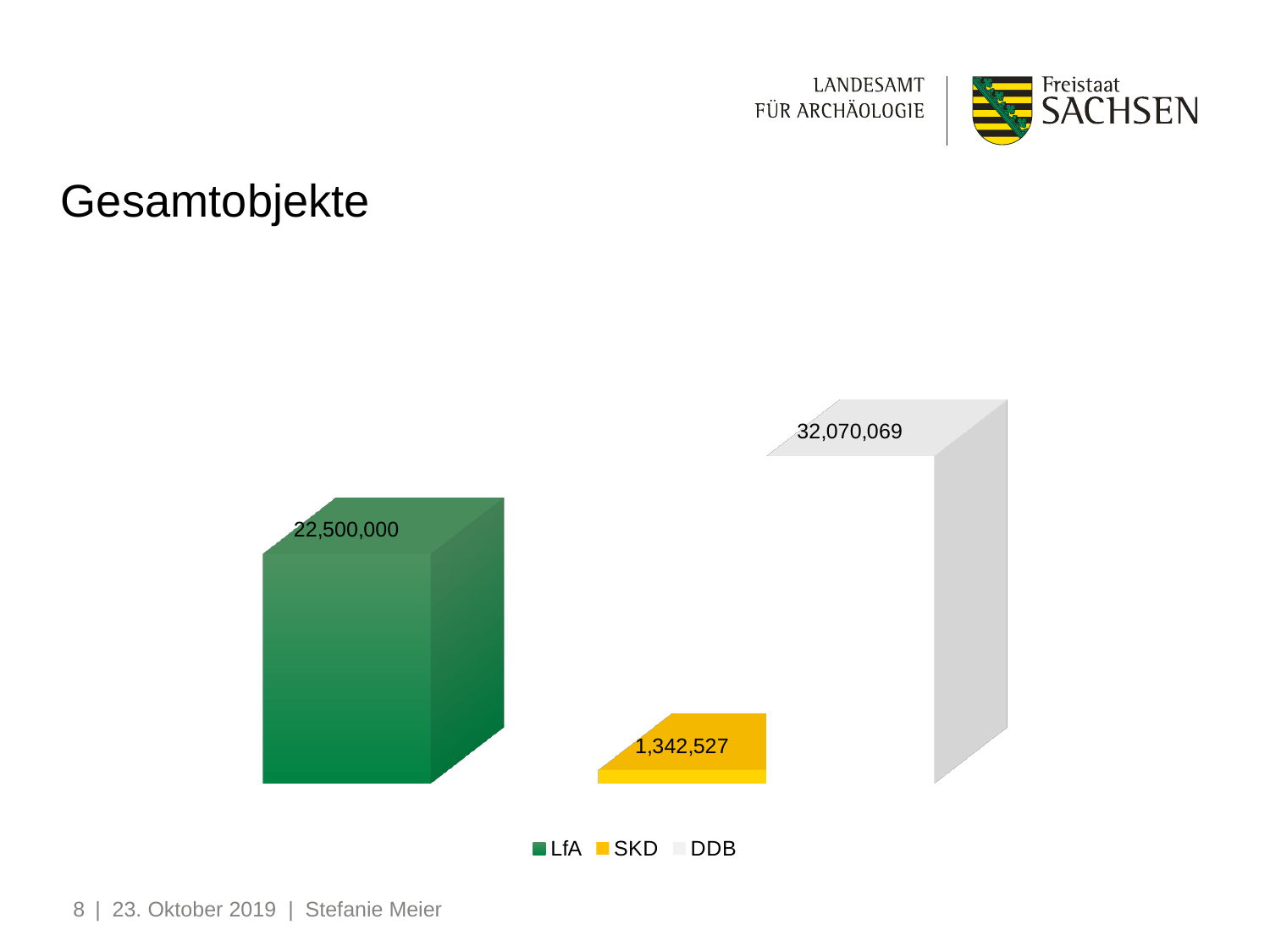
Which series has the highest value? DDB Which series has the lowest value? SKD What is the difference between the LfA value and the SKD value? 21,157,473 What is the difference between the DDB value and the LfA value? 9,570,069 What kind of chart is shown on the slide? Bar chart Which is larger, the value for LfA or the value for SKD? LfA What is the value shown for LfA? 22,500,000 What is the value shown for DDB? 32,070,069 What is the title of the slide containing the chart? Gesamtobjekte What is the value shown for SKD? 1,342,527 How many series does the legend list? 3 Which is larger, the value for DDB or the value for LfA? DDB